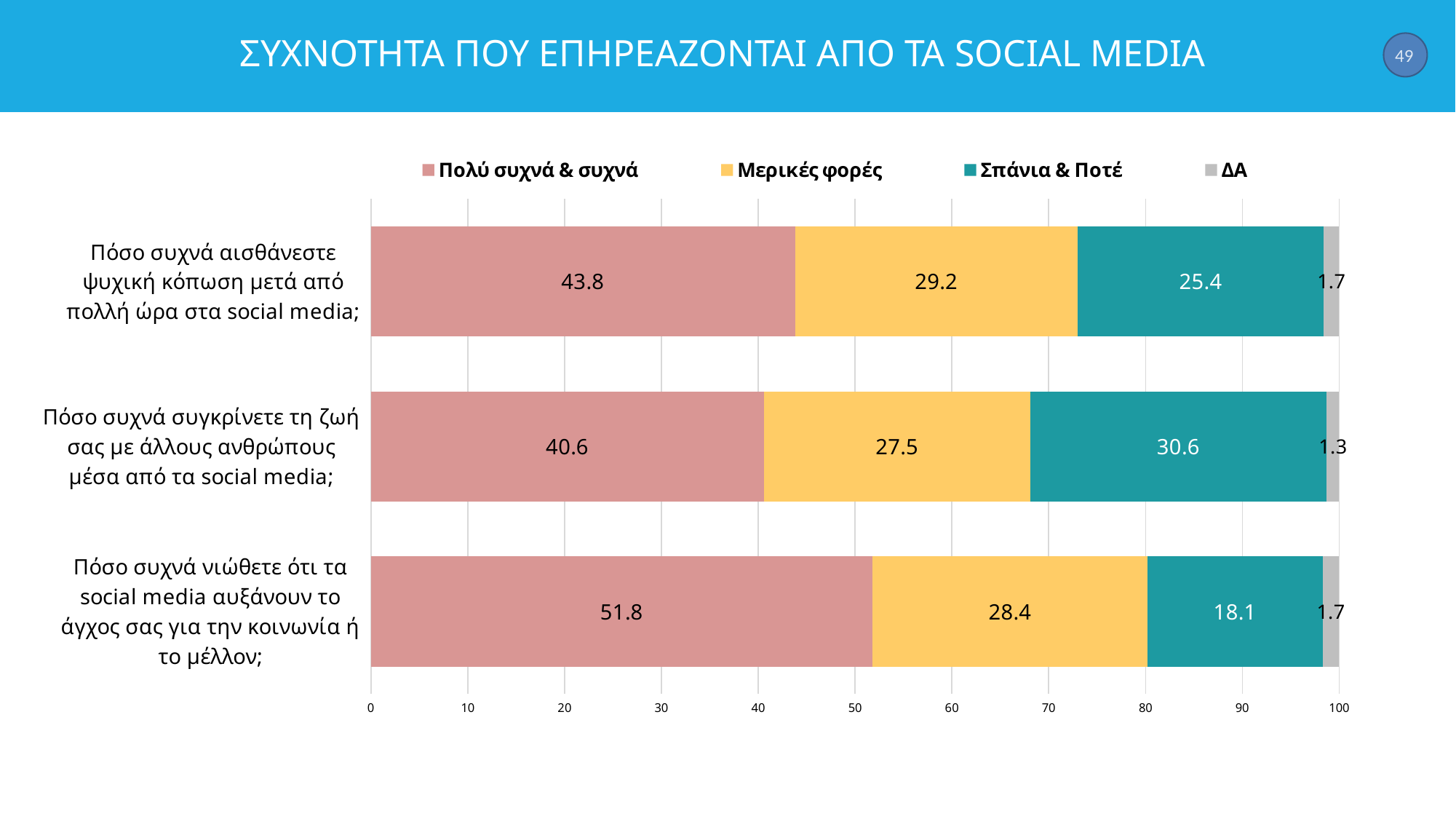
What is the difference between the "Πολύ συχνά & συχνά" values for "Πόσο συχνά νιώθετε ότι τα social media αυξάνουν το άγχος σας για την κοινωνία ή το μέλλον;" and "Πόσο συχνά συγκρίνετε τη ζωή σας με άλλους ανθρώπους μέσα από τα social media;"? 11.2 Which category has the lowest value for "Σπάνια & Ποτέ"? Πόσο συχνά νιώθετε ότι τα social media αυξάνουν το άγχος σας για την κοινωνία ή το μέλλον; What is the value of "Μερικές φορές" for "Πόσο συχνά αισθάνεστε ψυχική κόπωση μετά από πολλή ώρα στα social media;"? 29.2 How many categories (questions) are shown on the chart? 3 What kind of chart is shown on the slide? Stacked bar chart What is the total of the stacked bar for "Πόσο συχνά συγκρίνετε τη ζωή σας με άλλους ανθρώπους μέσα από τα social media;"? 100.0 What is the value of "Σπάνια & Ποτέ" for "Πόσο συχνά συγκρίνετε τη ζωή σας με άλλους ανθρώπους μέσα από τα social media;"? 30.6 Which category has the highest value for "Πολύ συχνά & συχνά"? Πόσο συχνά νιώθετε ότι τα social media αυξάνουν το άγχος σας για την κοινωνία ή το μέλλον; How many series does the legend list? 4 What is the value of "Πολύ συχνά & συχνά" for "Πόσο συχνά νιώθετε ότι τα social media αυξάνουν το άγχος σας για την κοινωνία ή το μέλλον;"? 51.8 What is the value of "ΔΑ" for "Πόσο συχνά συγκρίνετε τη ζωή σας με άλλους ανθρώπους μέσα από τα social media;"? 1.3 Which is larger: the "Σπάνια & Ποτέ" value for "Πόσο συχνά αισθάνεστε ψυχική κόπωση μετά από πολλή ώρα στα social media;" or for "Πόσο συχνά συγκρίνετε τη ζωή σας με άλλους ανθρώπους μέσα από τα social media;"? Πόσο συχνά συγκρίνετε τη ζωή σας με άλλους ανθρώπους μέσα από τα social media;